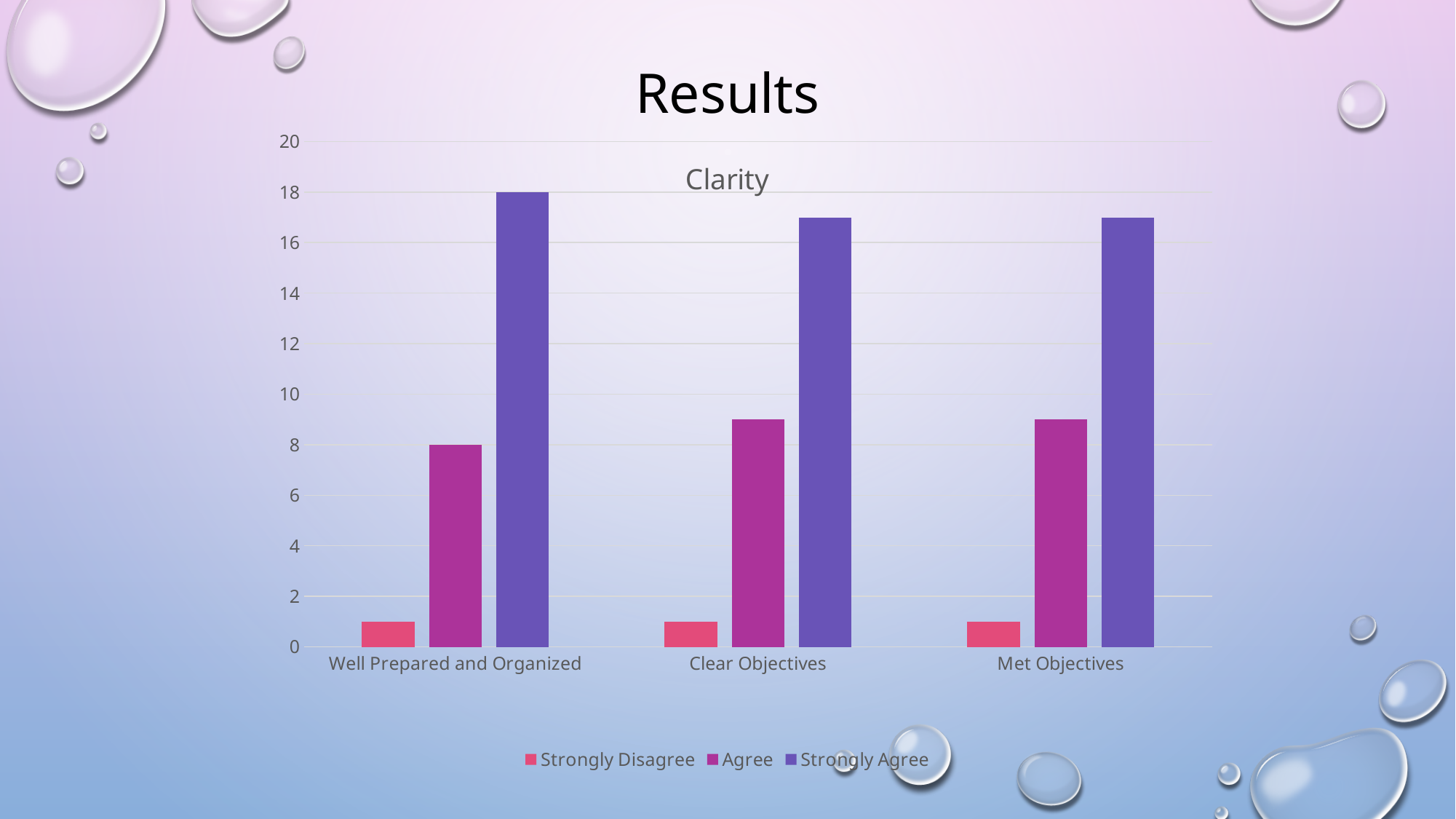
How many categories are shown on the x axis? 3 What kind of chart is shown on the slide? bar chart Is the Agree value for Met Objectives greater or less than 10? less Which category has the highest Strongly Agree value? Well Prepared and Organized What is the Strongly Agree value for Well Prepared and Organized? 18 Is the Strongly Agree value for Clear Objectives greater or less than 16? greater What is the Agree value for Well Prepared and Organized? 8 For Met Objectives, which is larger: the Agree value or the Strongly Agree value? Strongly Agree How many series does the legend list? 3 Is the Strongly Disagree value for Clear Objectives greater or less than 2? less Which series has the lowest values across all categories? Strongly Disagree What is the title of the chart? Clarity